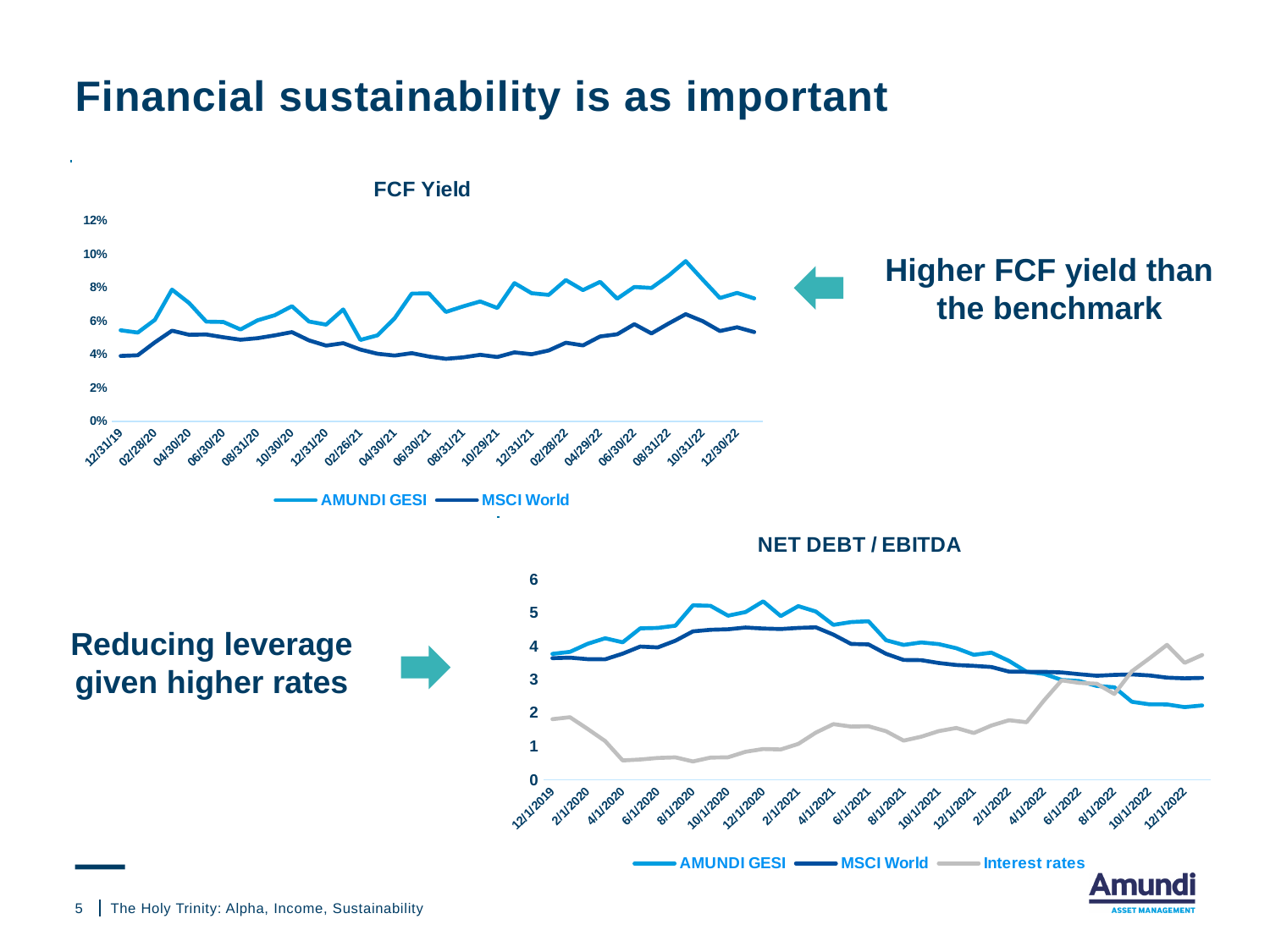
In the NET DEBT / EBITDA chart, which series is higher at 12/1/2022, AMUNDI GESI or MSCI World? MSCI World In the NET DEBT / EBITDA chart, is the value for AMUNDI GESI at 12/1/2020 greater or less than 5? greater What is the title of the lower chart on the slide? NET DEBT / EBITDA In the FCF Yield chart, is the value for AMUNDI GESI at 10/31/22 greater or less than 8%? greater How many series does the legend of the NET DEBT / EBITDA chart list? 3 What kind of chart is the FCF Yield chart? line chart In the FCF Yield chart, is the value for MSCI World at 12/31/19 greater or less than 6%? less In the FCF Yield chart, which series is higher at 10/31/22, AMUNDI GESI or MSCI World? AMUNDI GESI How many series does the legend of the FCF Yield chart list? 2 In the NET DEBT / EBITDA chart, does the AMUNDI GESI line rise or fall from 12/1/2020 to 12/1/2022? fall